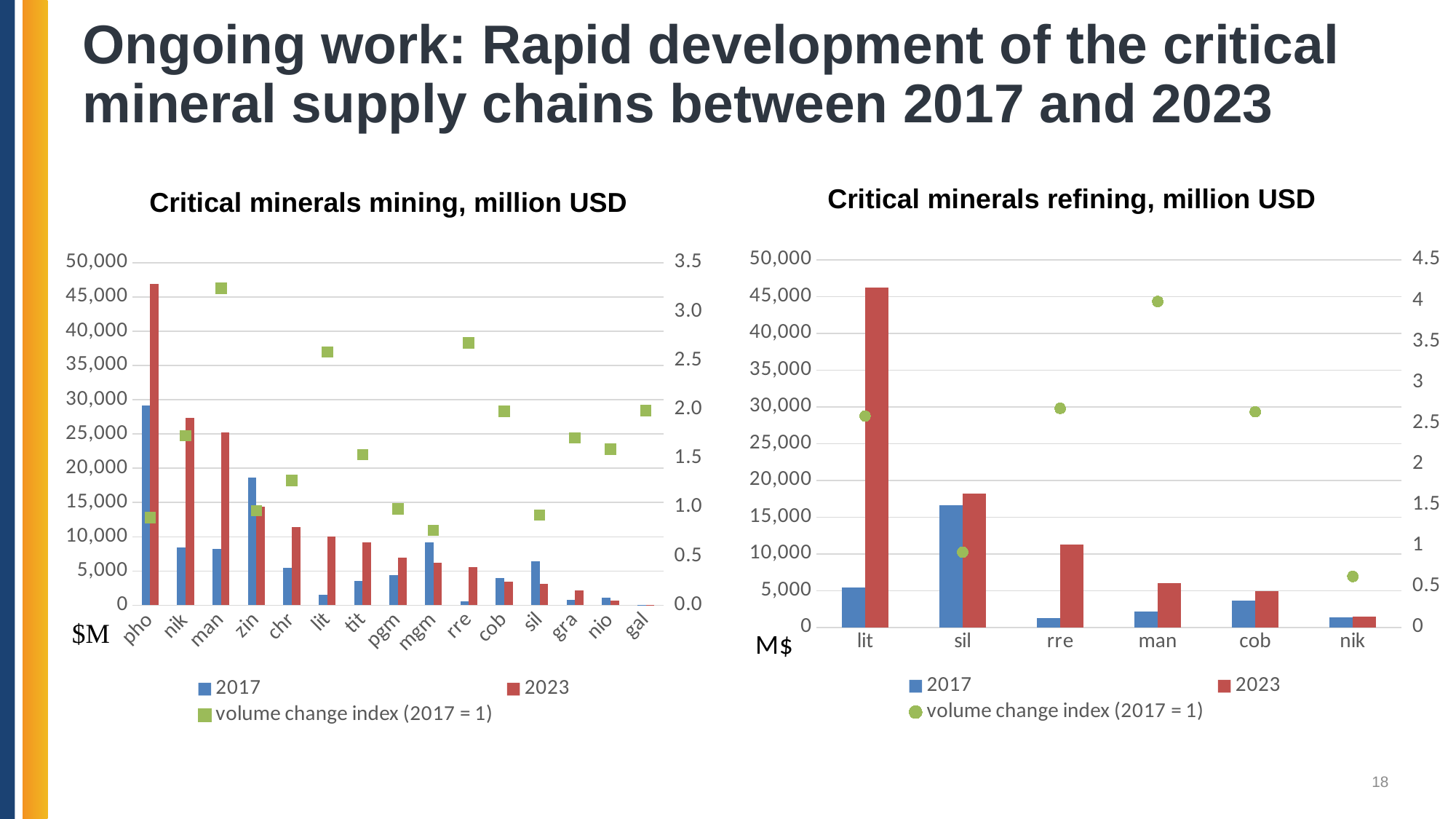
In the 'Critical minerals refining, million USD' chart, which mineral has the highest 2023 value? lit In the 'Critical minerals refining, million USD' chart, which is larger: the 2023 value for lit or the 2023 value for sil? lit How many series does the legend of the 'Critical minerals refining, million USD' chart list? 3 In the 'Critical minerals refining, million USD' chart, is the 2017 value for sil greater or less than 15,000? greater In the 'Critical minerals refining, million USD' chart, which mineral has the lowest 2023 value? nik What kind of chart is the 'Critical minerals mining, million USD' chart? bar chart (with a volume change index plotted as markers) How many mineral categories are shown on the x axis of the 'Critical minerals mining, million USD' chart? 15 In the 'Critical minerals mining, million USD' chart, is the 2023 value for pho greater or less than 45,000? greater In the 'Critical minerals mining, million USD' chart, which mineral has the highest 2023 value? pho How many mineral categories are shown on the x axis of the 'Critical minerals refining, million USD' chart? 6 In the 'Critical minerals mining, million USD' chart, which is larger for zin: the 2017 value or the 2023 value? 2017 In the 'Critical minerals mining, million USD' chart, is the volume change index for man greater or less than 3.0? greater